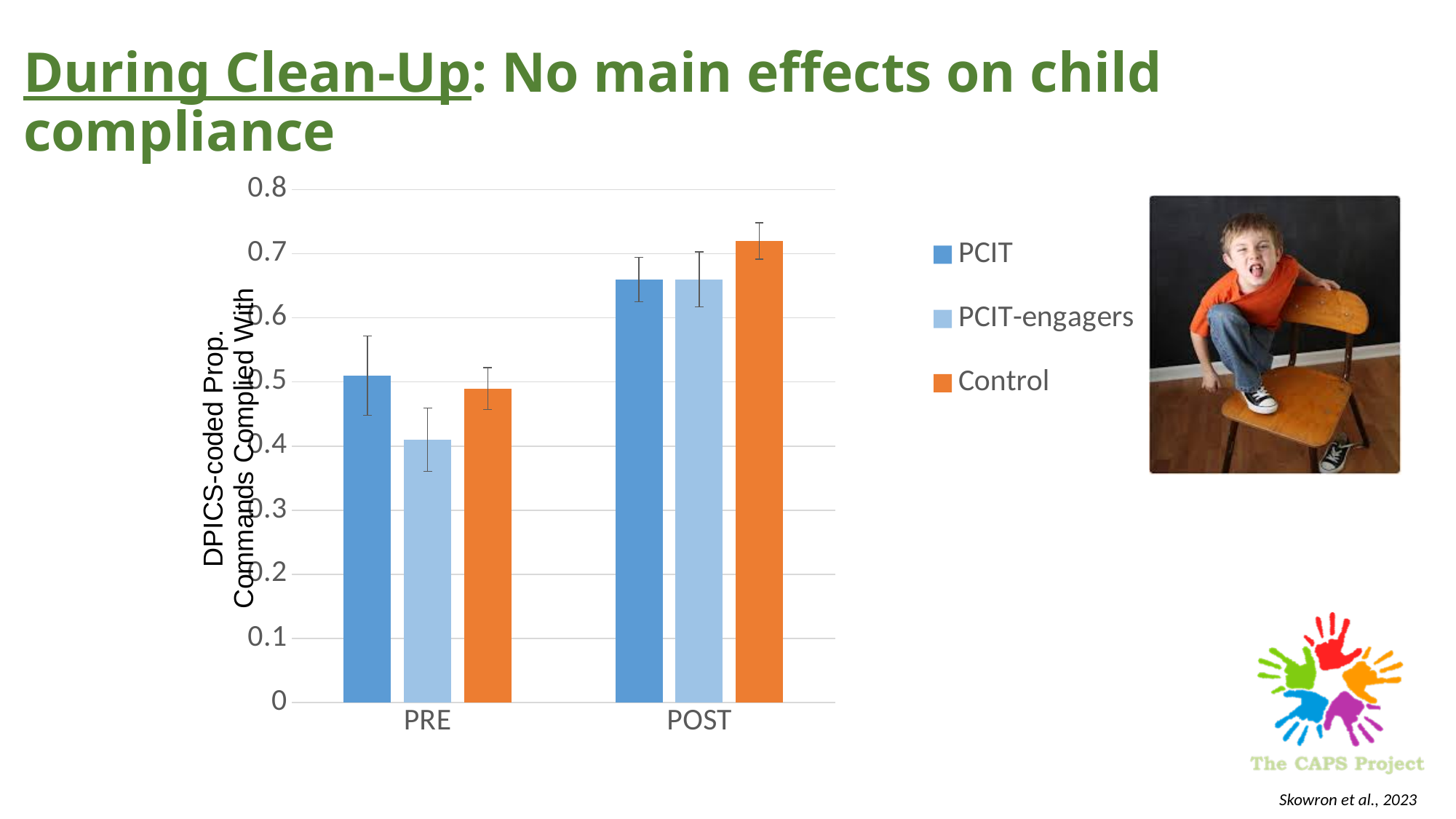
Is the value for PCIT at POST greater or less than 0.6? greater How many categories are shown on the x axis? 2 Which series has the lowest value at PRE? PCIT-engagers Is the value for PCIT-engagers at PRE greater or less than 0.5? less At POST, which is larger: the value for Control or the value for PCIT-engagers? Control How many series does the legend list? 3 Which series has the highest value at POST? Control At PRE, which is larger: the value for PCIT or the value for PCIT-engagers? PCIT Is the value for Control at POST greater or less than 0.7? greater What is the label on the vertical axis of the chart? DPICS-coded Prop. Commands Complied With What kind of chart is shown on the slide? bar chart Does the value for PCIT rise or fall from PRE to POST? rise